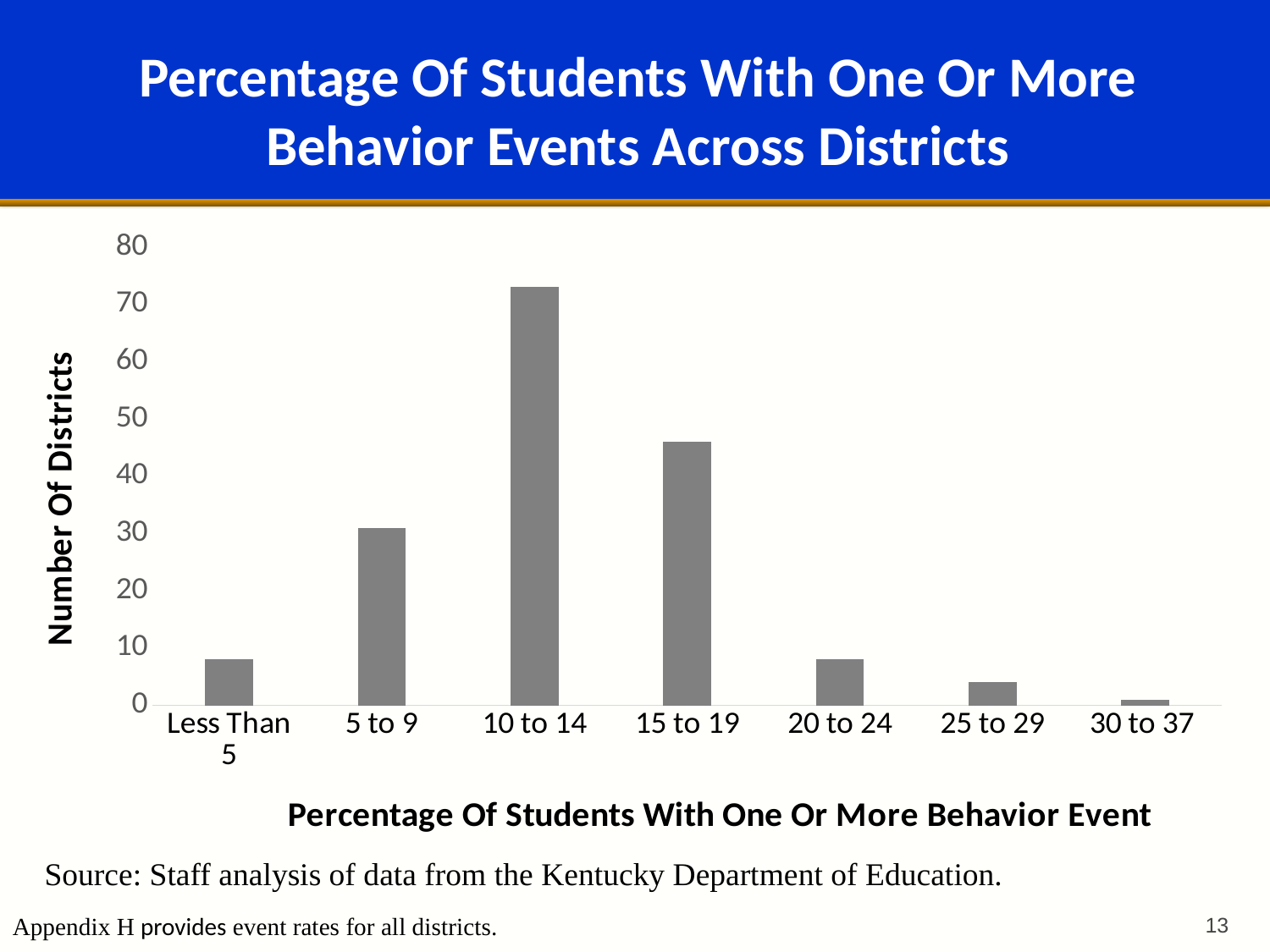
How many percentage ranges are shown on the x axis? 7 Is the number of districts for Less Than 5 greater or less than 20? less Is the number of districts for 5 to 9 greater or less than 40? less Is the number of districts for 15 to 19 greater or less than 40? greater What is the label of the vertical axis? Number Of Districts Which has more districts, 20 to 24 or 25 to 29? 20 to 24 Which has more districts, 5 to 9 or 15 to 19? 15 to 19 Which percentage range has the lowest number of districts? 30 to 37 Which percentage range has the highest number of districts? 10 to 14 What kind of chart is shown on the slide? bar chart